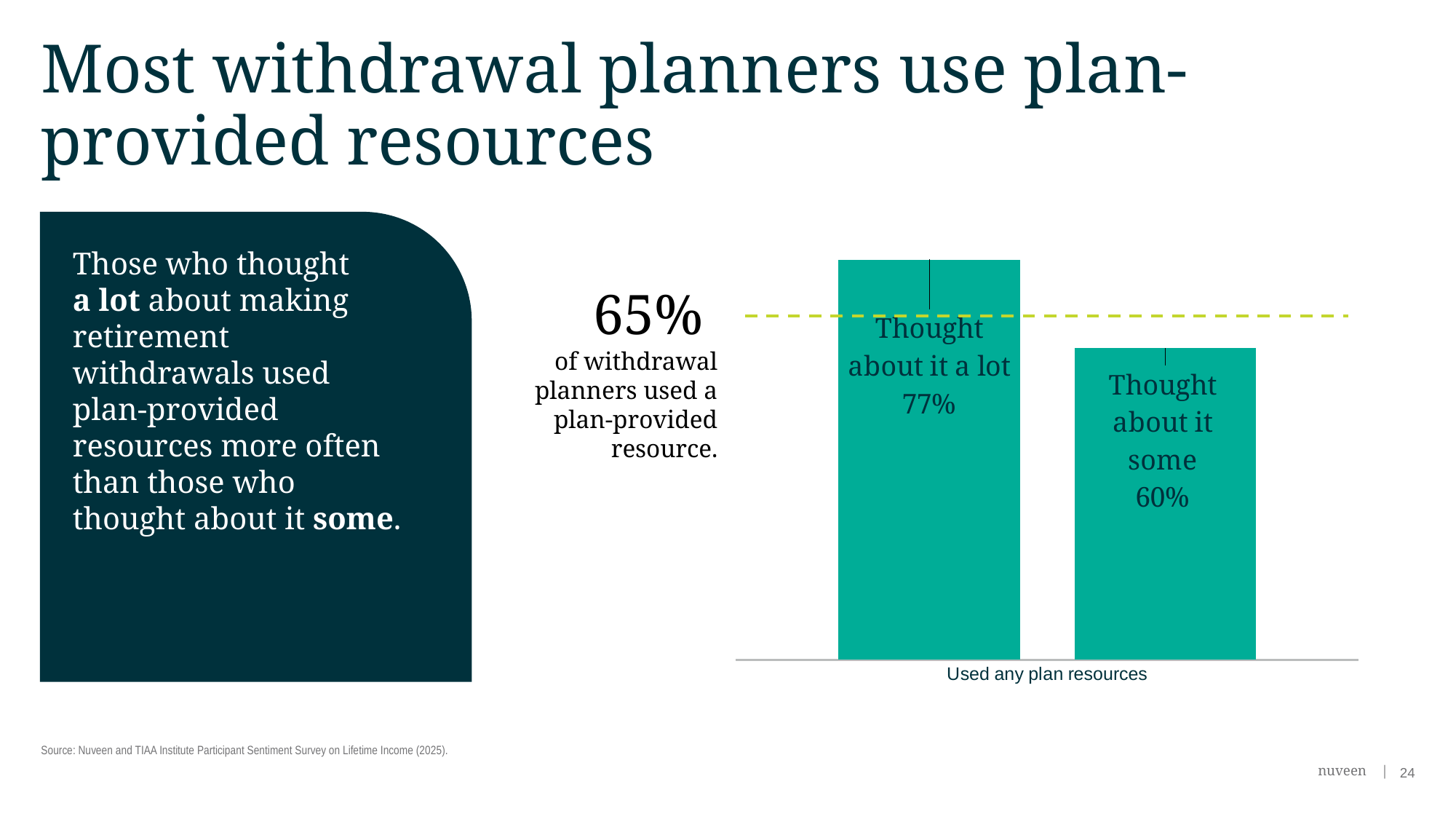
What percentage of those who thought about it a lot used any plan resources? 77% How many bars are shown in the chart? 2 What is the difference in percentage points between the 'Thought about it a lot' and 'Thought about it some' bars? 17 Is the value for 'Thought about it a lot' larger or smaller than the value for 'Thought about it some'? larger What is the category label shown beneath the bars on the x axis? Used any plan resources What percentage of those who thought about it some used any plan resources? 60% Which group has the lower share using any plan resources? Thought about it some What kind of chart is shown on the slide? Bar chart What overall percentage of withdrawal planners used a plan-provided resource, as stated next to the chart? 65% Which group has the higher share using any plan resources? Thought about it a lot